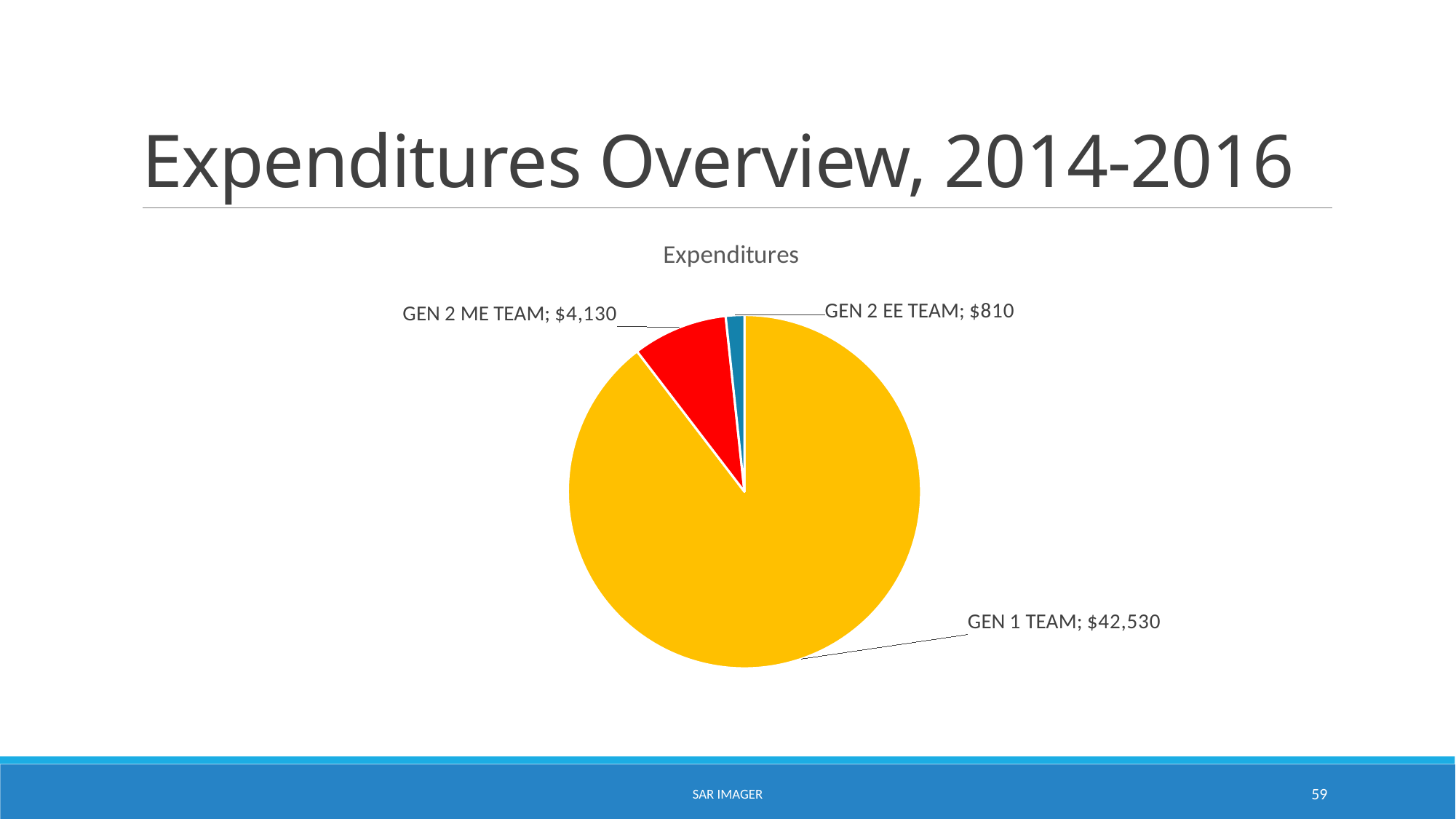
Which is larger, the expenditure for GEN 2 ME TEAM or GEN 2 EE TEAM? GEN 2 ME TEAM What is the difference between the expenditures of GEN 1 TEAM and GEN 2 ME TEAM? $38,400 How many slices does the pie chart have? 3 What is the expenditure for GEN 2 EE TEAM? $810 What is the total of all expenditures shown in the pie chart? $47,470 Which team has the highest expenditure? GEN 1 TEAM What is the expenditure for GEN 1 TEAM? $42,530 What type of chart is shown on the slide? Pie chart What is the expenditure for GEN 2 ME TEAM? $4,130 What is the difference between the expenditures of GEN 2 ME TEAM and GEN 2 EE TEAM? $3,320 Which team has the lowest expenditure? GEN 2 EE TEAM What is the title of the chart? Expenditures